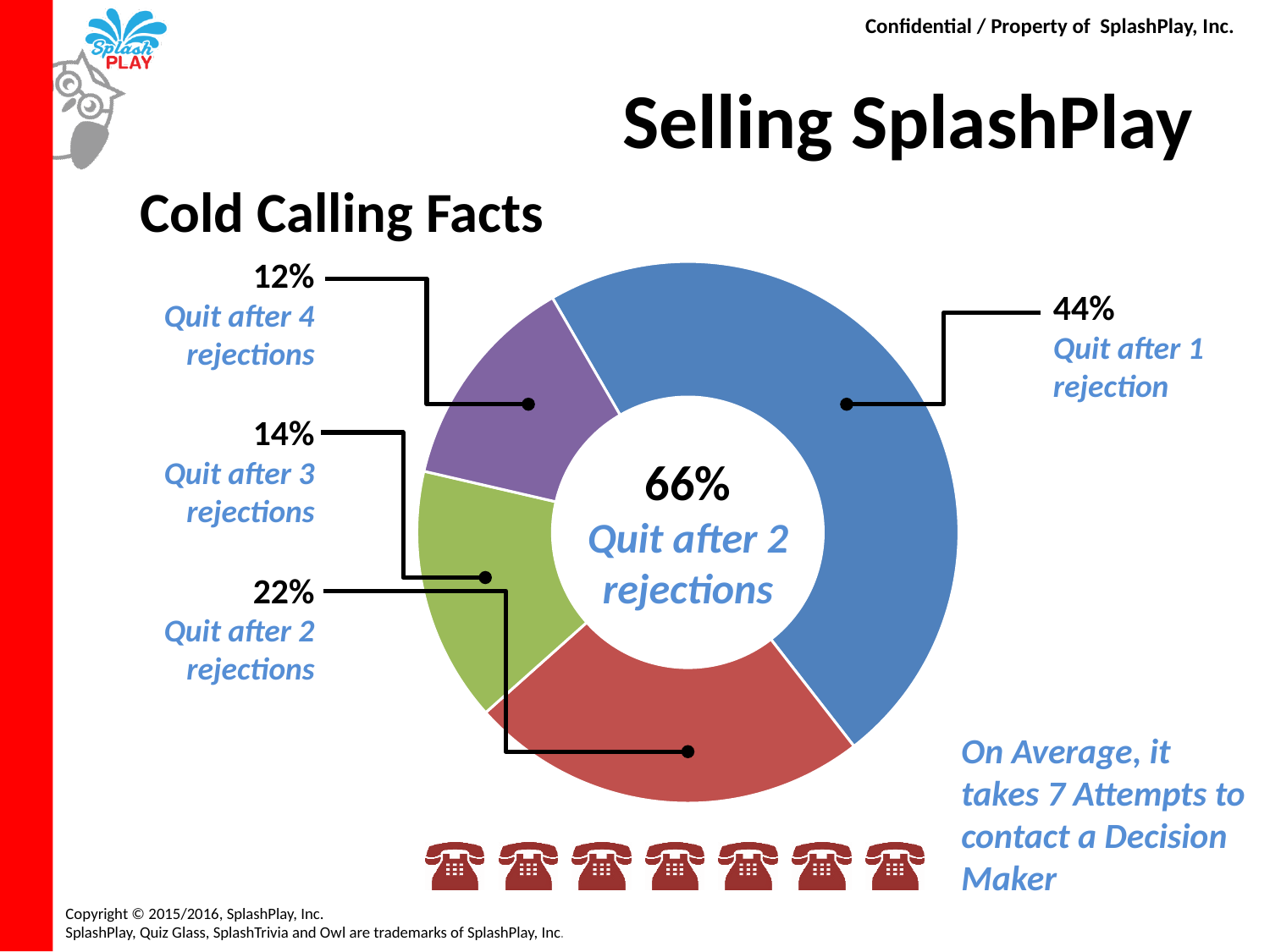
What is the difference between the share that quit after 1 rejection and the share that quit after 2 rejections? 22% What percentage is printed in the centre of the donut chart? 66% Which category has the smallest share of the pie? Quit after 4 rejections Which category has the largest share of the pie? Quit after 1 rejection What percentage quit after 2 rejections? 22% What kind of chart is shown under "Cold Calling Facts"? Pie chart (donut) What colour is the slice for "Quit after 1 rejection"? Blue What percentage quit after 3 rejections? 14% How many slices does the pie chart have? 4 What percentage quit after 4 rejections? 12% What percentage of cold callers quit after 1 rejection? 44% Which is larger: the share that quit after 3 rejections or the share that quit after 4 rejections? Quit after 3 rejections